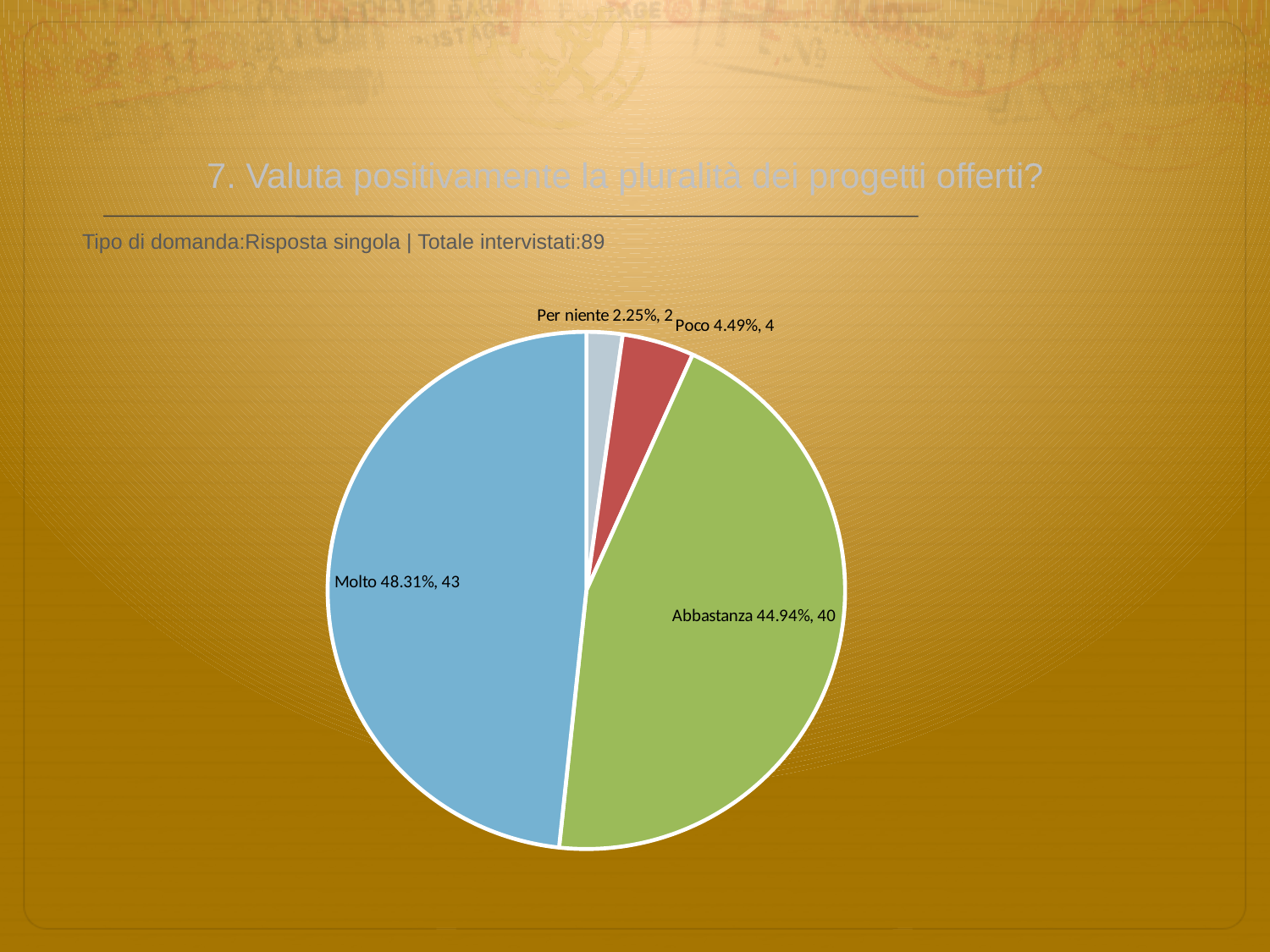
How many respondents answered 'Per niente'? 2 What kind of chart is shown on the slide? pie chart What percentage share does the 'Molto' slice have? 48.31% How many respondents answered 'Abbastanza'? 40 Which has more respondents, 'Poco' or 'Per niente'? Poco What colour is the 'Abbastanza' slice? green How many slices does the pie chart have? 4 What is the difference in respondent count between 'Molto' and 'Abbastanza'? 3 Which category has the smallest slice of the pie? Per niente What is the total number of respondents across all slices? 89 Which category has the largest slice of the pie? Molto What percentage share does the 'Poco' slice have? 4.49%